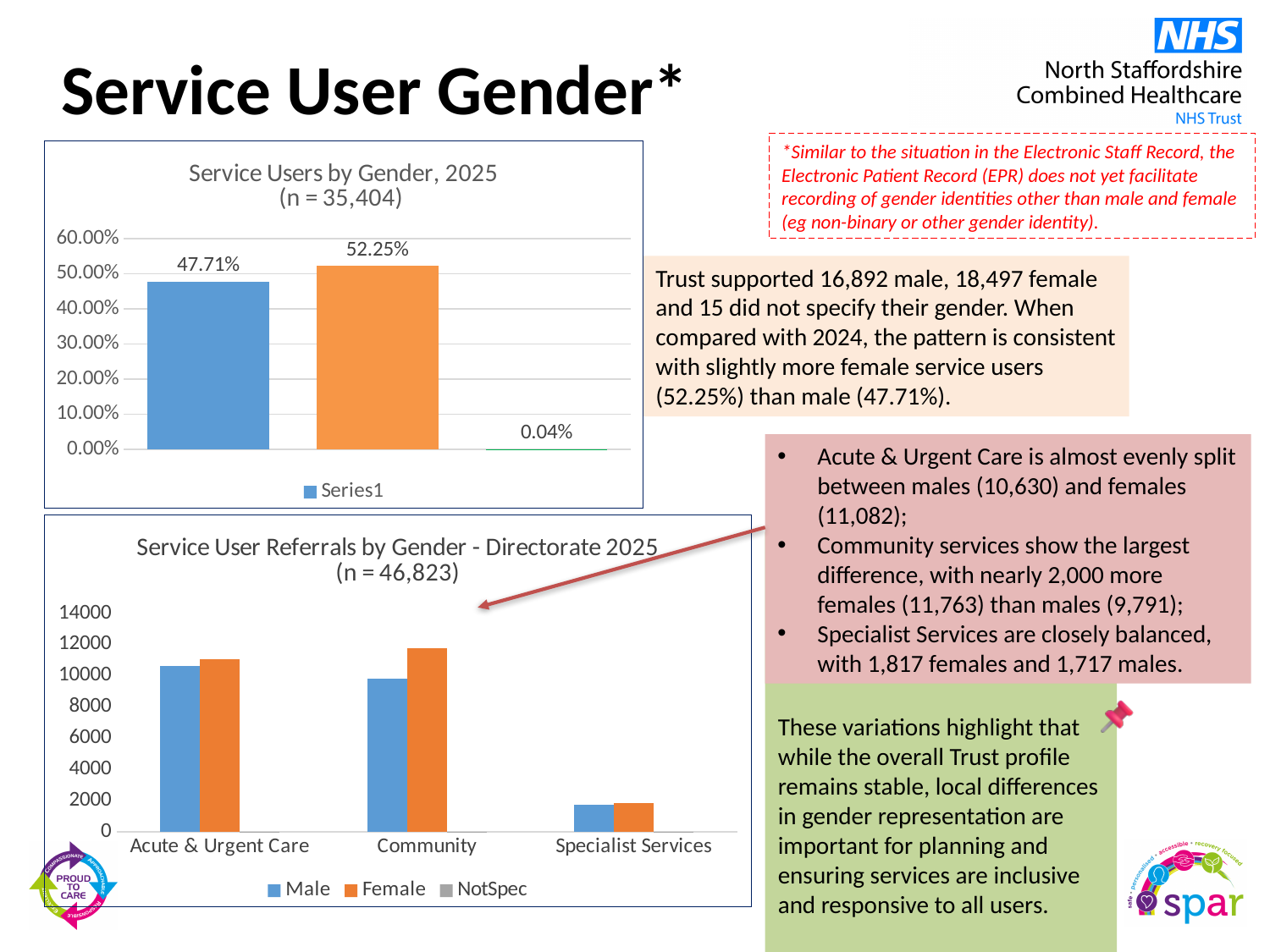
In the 'Service Users by Gender, 2025' chart, what is the smallest value labelled? 0.04% In the 'Service Users by Gender, 2025' chart, what is the difference between the two largest values, 52.25% and 47.71%? 4.54% In the 'Service User Referrals by Gender - Directorate 2025' chart, is the Male value for Acute & Urgent Care greater or less than 10000? greater What kind of chart is the 'Service Users by Gender, 2025' chart? bar chart How many series does the legend of the 'Service User Referrals by Gender - Directorate 2025' chart list? 3 In the 'Service User Referrals by Gender - Directorate 2025' chart, which directorate has the lowest Female value? Specialist Services In the 'Service User Referrals by Gender - Directorate 2025' chart, is the Female value for Community greater or less than 10000? greater What is the sample size (n) stated in the title of the 'Service User Referrals by Gender - Directorate 2025' chart? 46,823 In the 'Service Users by Gender, 2025' chart, what is the value shown on the orange bar? 52.25% How many bars are plotted in the 'Service Users by Gender, 2025' chart? 3 In the 'Service User Referrals by Gender - Directorate 2025' chart, which is larger for Community: Male or Female? Female In the 'Service Users by Gender, 2025' chart, what is the value shown on the blue bar? 47.71%